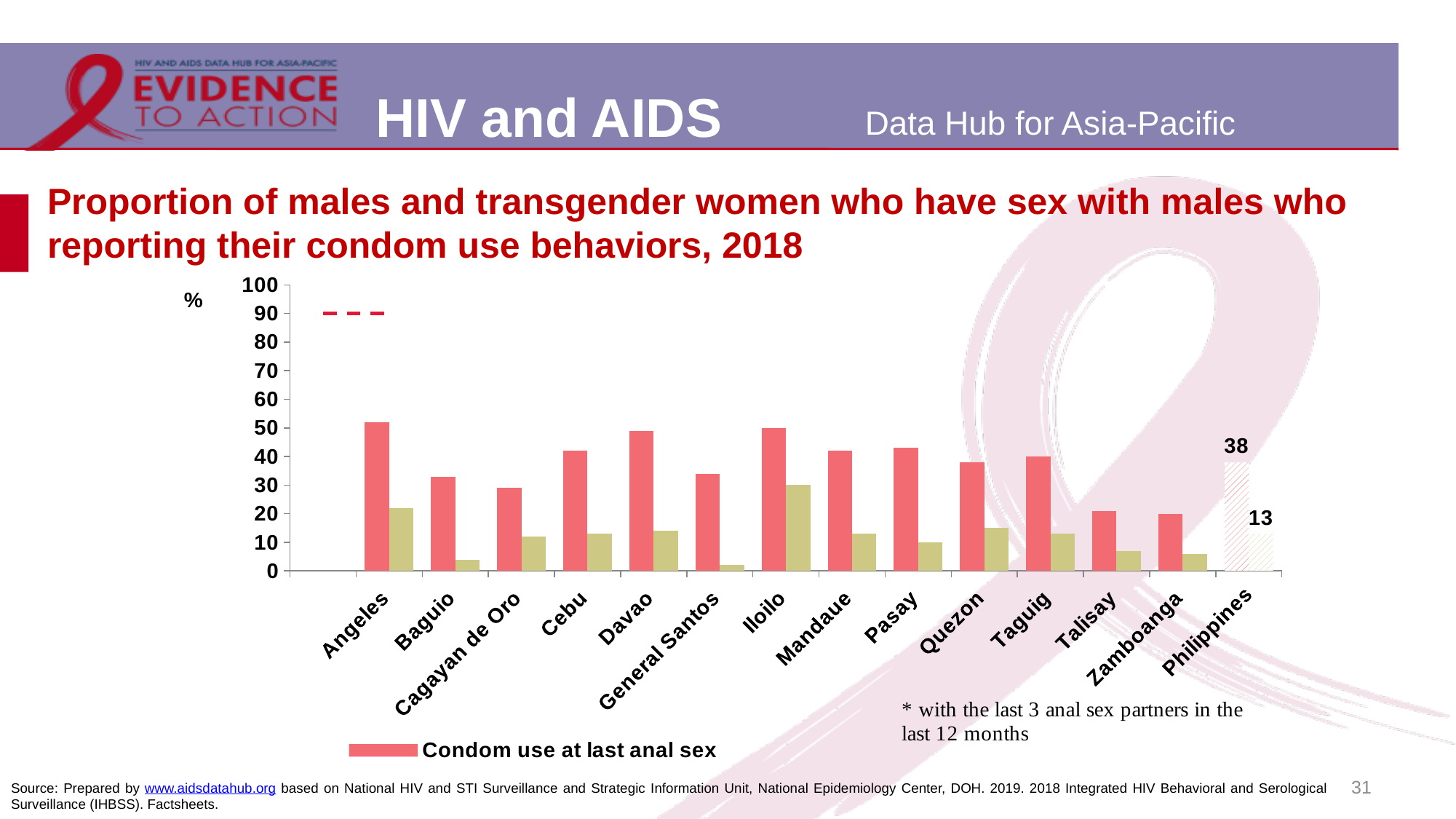
Is the red bar for Angeles greater or less than 40? greater Which has the larger red bar, Cebu or Baguio? Cebu How many categories are shown along the x axis of the chart? 14 What is the difference between the two values printed for Philippines (38 and 13)? 25 Which city has the highest olive (second series) bar? Iloilo Is the red bar for Baguio greater or less than 40? less Is the olive bar for Iloilo greater or less than 20? greater What is the value of the red bar (condom use at last anal sex) for Philippines? 38 What type of chart is shown on the slide? bar chart What label does the legend give for the red bars? Condom use at last anal sex What is the value of the second (olive) bar for Philippines? 13